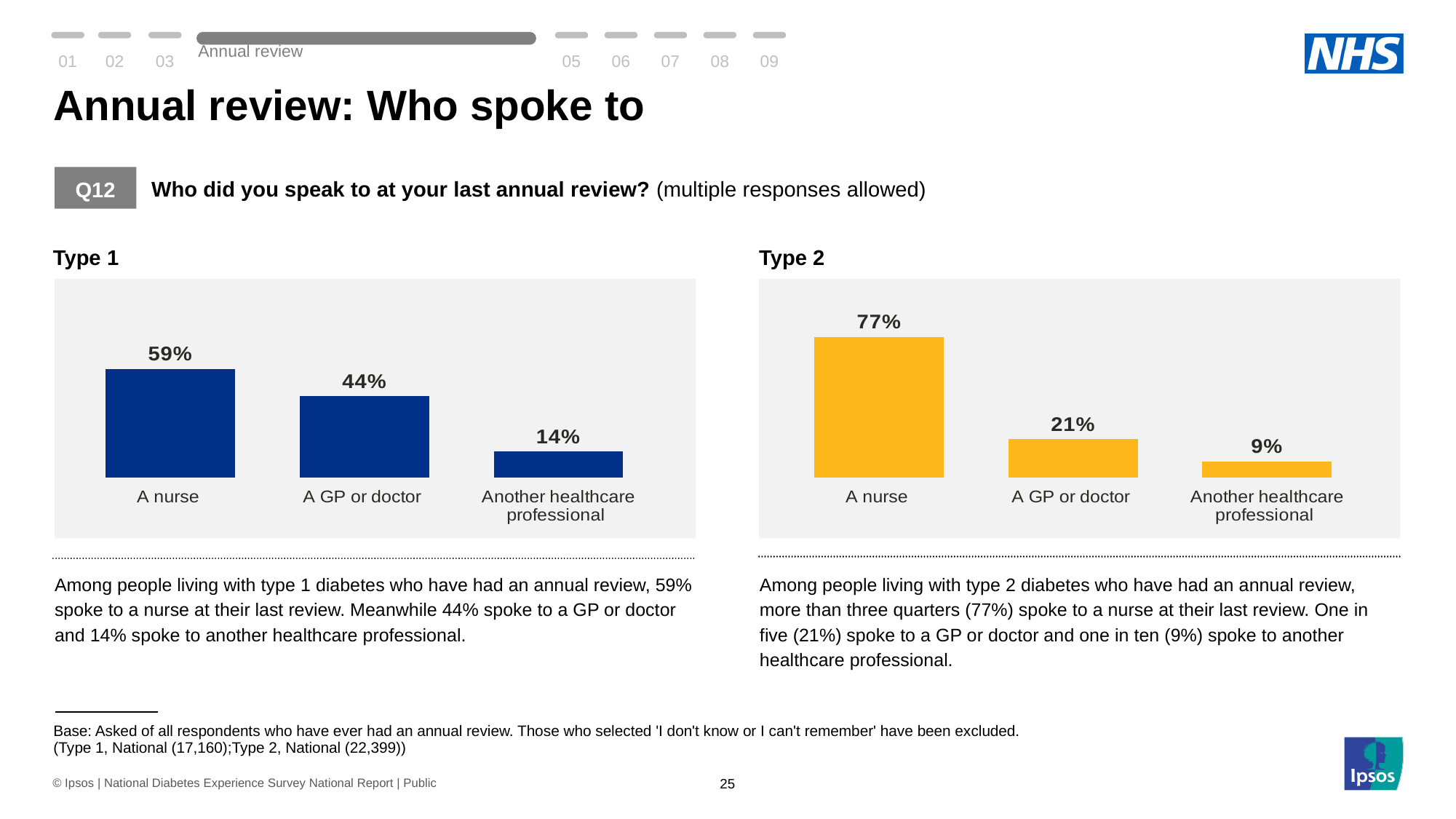
In the Type 2 chart, what is the difference between the values for 'A nurse' and 'A GP or doctor'? 56 percentage points Do the values in the Type 2 chart rise or fall from left to right? Fall In the Type 1 chart, what is the difference between the values for 'A nurse' and 'A GP or doctor'? 15 percentage points What kind of chart is the Type 1 chart? Bar chart In the Type 1 chart, what percentage spoke to a nurse? 59% In the Type 1 chart, which category has the lowest value? Another healthcare professional How many categories are shown in the Type 2 chart? 3 In the Type 1 chart, what is the value for 'Another healthcare professional'? 14% What colour are the bars in the Type 2 chart? Yellow In the Type 2 chart, which category has the highest value? A nurse Which is larger: the value for 'A nurse' in the Type 1 chart or the value for 'A nurse' in the Type 2 chart? Type 2 In the Type 2 chart, what percentage spoke to a GP or doctor? 21%